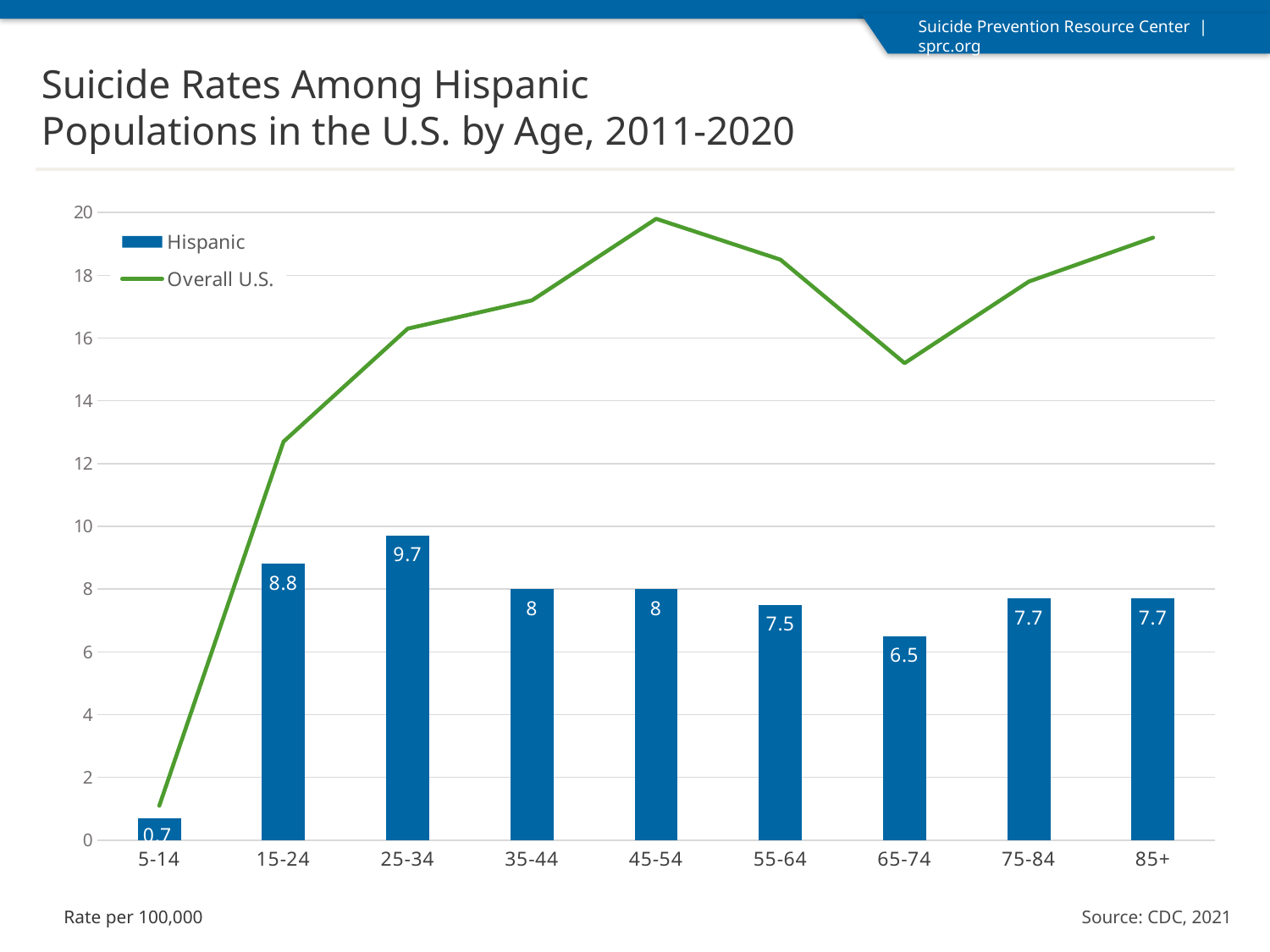
What unit is the rate expressed in, according to the note below the chart? Rate per 100,000 Which age group has the lowest Hispanic suicide rate? 5-14 What is the Hispanic suicide rate for the 25-34 age group? 9.7 How many series does the legend list? 2 How many age groups are shown on the x axis? 9 Is the Overall U.S. value for the 65-74 age group greater or less than 16? less What is the Hispanic suicide rate for the 65-74 age group? 6.5 Which age group has the highest Hispanic suicide rate? 25-34 What is the Hispanic suicide rate for the 5-14 age group? 0.7 What is the difference between the Hispanic suicide rates for the 25-34 and 15-24 age groups? 0.9 Is the Overall U.S. value for the 45-54 age group greater or less than 18? greater Which has a higher Hispanic suicide rate, the 55-64 age group or the 75-84 age group? 75-84